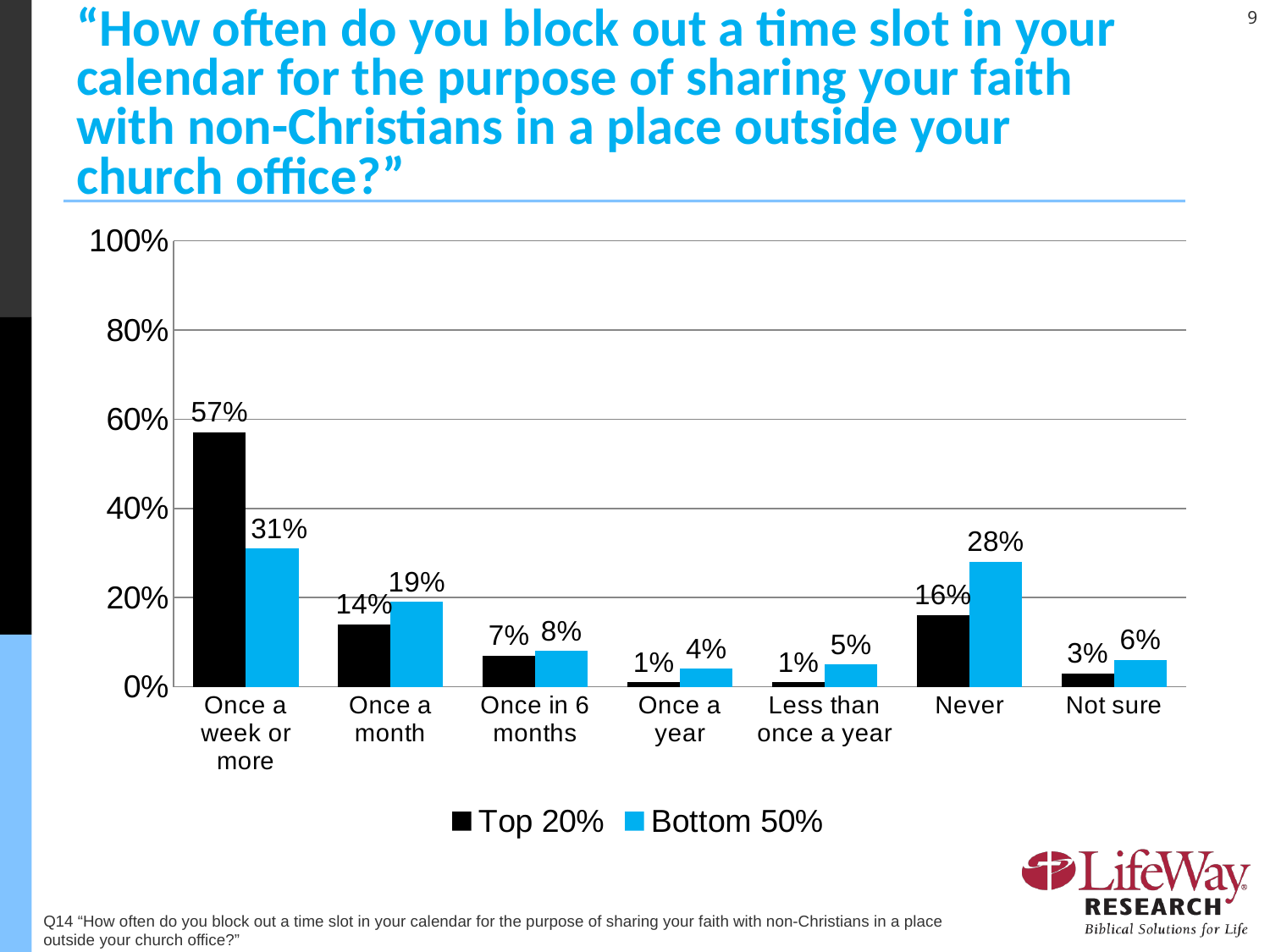
Which colour represents the Bottom 50% series? Blue What is the value for 'Never' in the Bottom 50% series? 28% What is the difference between the Top 20% and Bottom 50% values for 'Once a week or more'? 26% How many categories are shown on the x axis? 7 Which category has the highest value in the Top 20% series? Once a week or more Which category has the lowest value in the Bottom 50% series? Once a year Which is larger for 'Never': the Top 20% value or the Bottom 50% value? Bottom 50% What is the value for 'Once a month' in the Bottom 50% series? 19% How many series does the legend list? 2 What kind of chart is shown on the slide? Bar chart Is the Top 20% value for 'Once a week or more' greater or less than 40%? greater What is the value for 'Once a week or more' in the Top 20% series? 57%